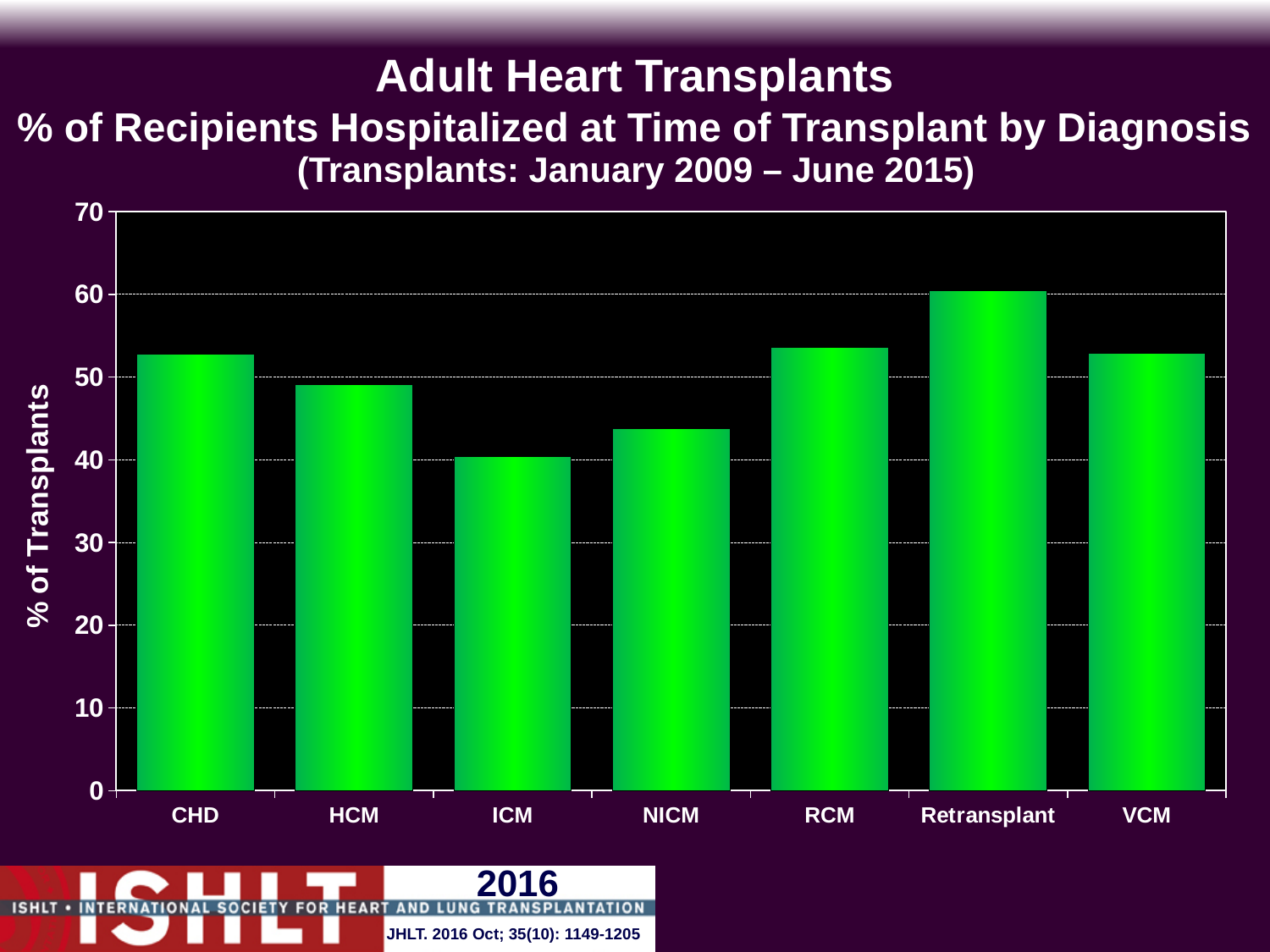
How many diagnosis categories are shown on the x axis? 7 What type of chart is shown on the slide? bar chart Which diagnosis has the lowest percentage of recipients hospitalized at time of transplant? ICM What is the label on the y axis of the chart? % of Transplants Which is larger, the value for HCM or the value for NICM? HCM Which is larger, the value for RCM or the value for ICM? RCM Which diagnosis has the highest percentage of recipients hospitalized at time of transplant? Retransplant Is the value for ICM greater or less than 50? less Is the value for NICM greater or less than 50? less Is the value for CHD greater or less than 50? greater What time period of transplants does the chart title say the data covers? January 2009 – June 2015